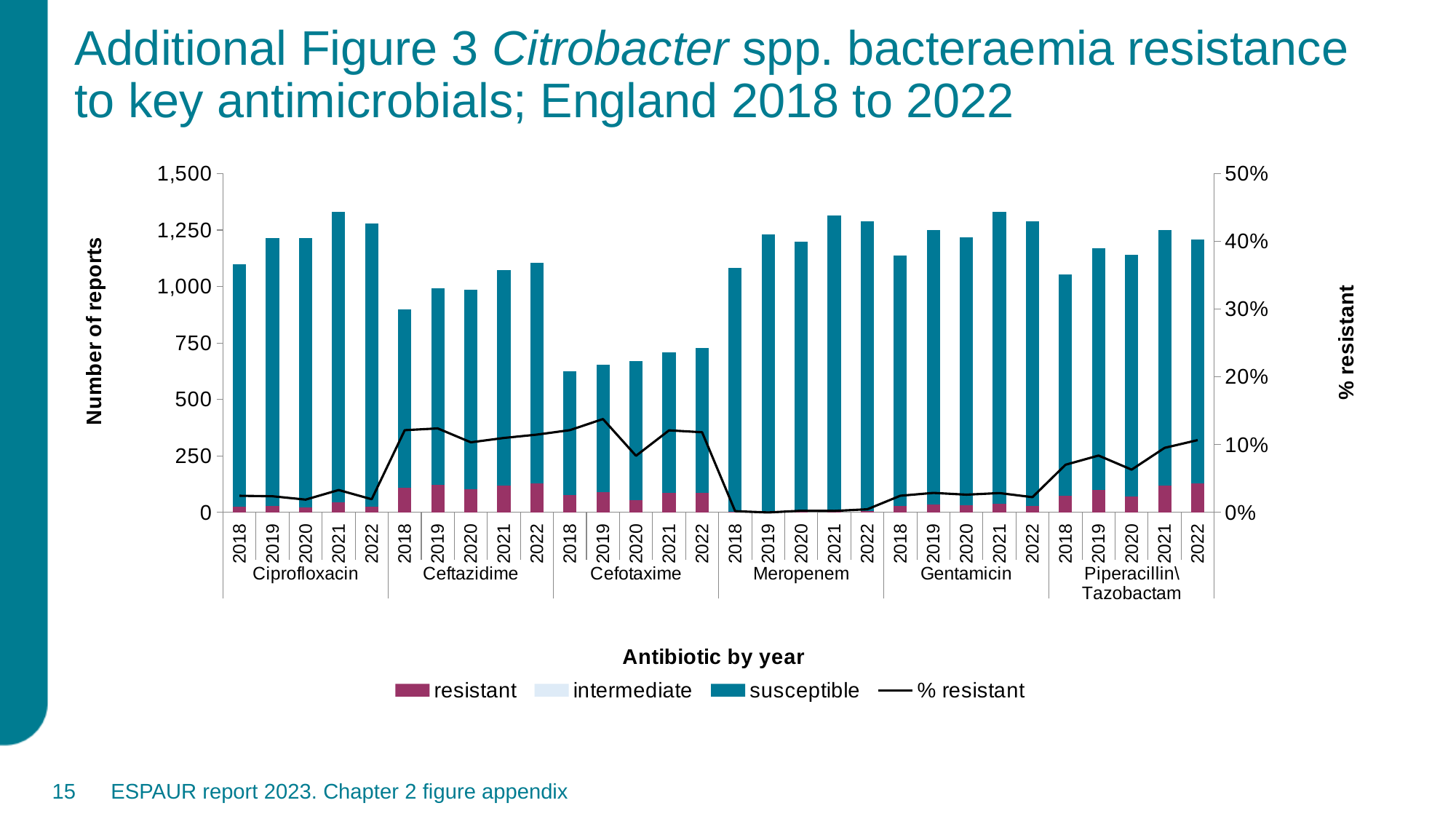
Is the total number of reports for Meropenem in 2021 greater or less than 1,250? greater Is the % resistant value for Ciprofloxacin in 2020 greater or less than 10%? less Is the % resistant value for Cefotaxime in 2019 greater or less than 10%? greater How many bars are plotted for each antibiotic? 5 What kind of chart is shown on the slide? Bar chart with a line Which antibiotic has the smallest total number of reports in 2018? Cefotaxime How many series does the legend list? 4 Do the total number of reports for Cefotaxime rise or fall from 2018 to 2022? rise Which antibiotic has the lowest % resistant line across all years? Meropenem How many antibiotics are shown along the x axis? 6 Which is larger, the total number of reports for Ciprofloxacin in 2018 or for Cefotaxime in 2018? Ciprofloxacin in 2018